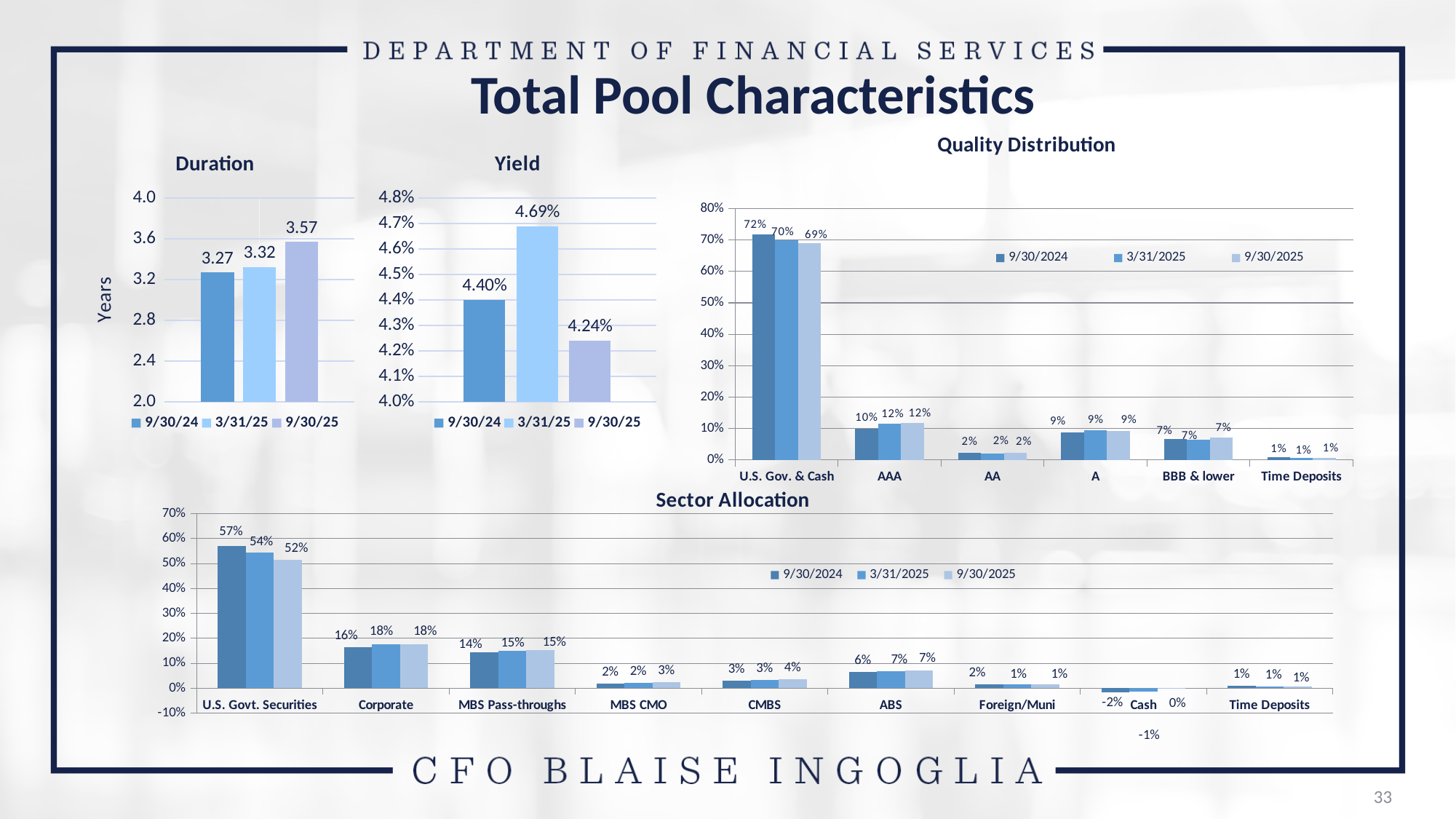
In the Duration chart, what is the difference between the 9/30/25 and 9/30/24 values? 0.30 In the Sector Allocation chart, does the U.S. Govt. Securities value rise or fall from 9/30/2024 to 9/30/2025? fall What kind of chart is the Sector Allocation chart? bar chart In the Yield chart, is the 9/30/24 yield greater or less than 4.3%? greater In the Quality Distribution chart, how many series does the legend list? 3 In the Sector Allocation chart, what is the value for Corporate on 3/31/2025? 18% In the Yield chart, what is the yield for 9/30/25? 4.24% In the Quality Distribution chart, which category has the lowest values? Time Deposits In the Quality Distribution chart, what is the value for U.S. Gov. & Cash on 9/30/2025? 69% In the Yield chart, which date has the highest yield? 3/31/25 In the Duration chart, what is the duration in years for 9/30/25? 3.57 In the Sector Allocation chart, how many sector categories are shown on the x axis? 9